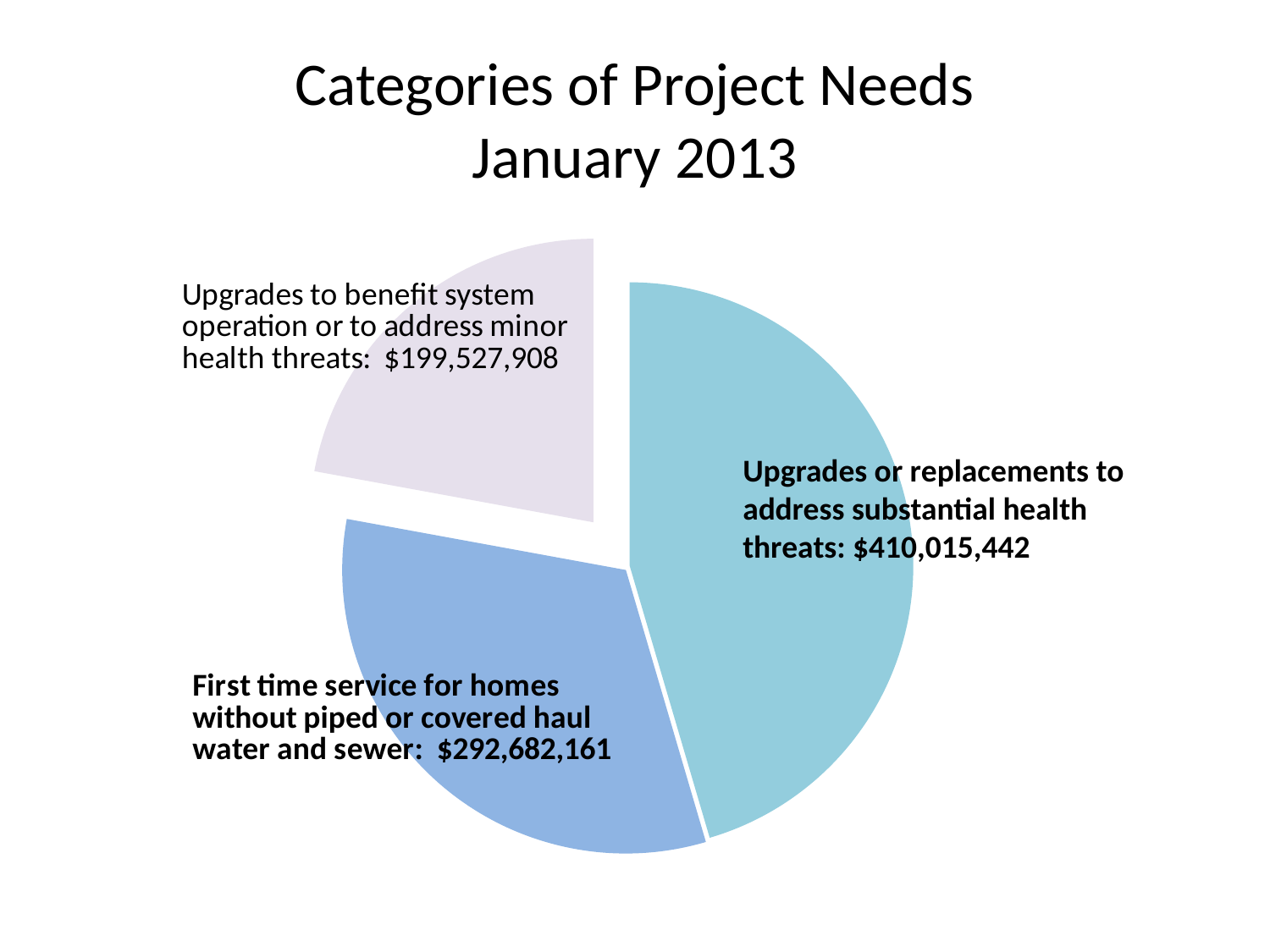
What is the title of the chart? Categories of Project Needs January 2013 What kind of chart is shown on the slide? Pie chart What is the value for 'First time service for homes without piped or covered haul water and sewer'? $292,682,161 Which category has the smallest value? Upgrades to benefit system operation or to address minor health threats What is the value for 'Upgrades or replacements to address substantial health threats'? $410,015,442 What is the total of all three categories shown? $902,225,511 What is the value for 'Upgrades to benefit system operation or to address minor health threats'? $199,527,908 How many categories are shown in the pie chart? 3 What is the difference between the value for first time service and the value for minor health threats? $93,154,253 Which is larger: the value for first time service or the value for minor health threats? First time service for homes without piped or covered haul water and sewer What is the difference between the value for substantial health threats and the value for first time service? $117,333,281 Which category has the largest value? Upgrades or replacements to address substantial health threats